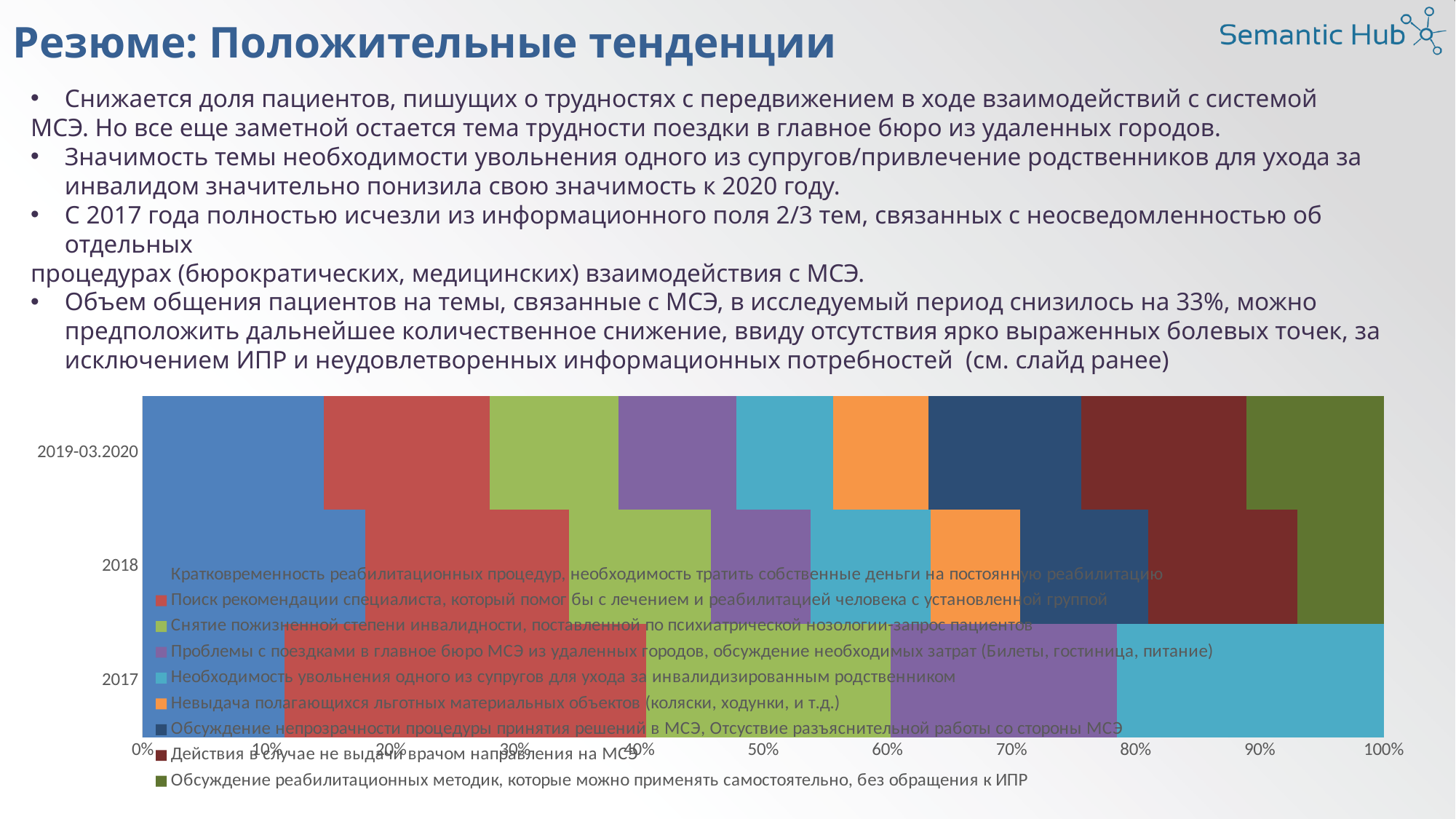
In which bar is the blue segment 'Кратковременность реабилитационных процедур...' larger: 2017 or 2019-03.2020? 2019-03.2020 What is the label of the topmost bar in the chart? 2019-03.2020 How many series does the chart legend list? 9 Is the share of the first (blue) series, 'Кратковременность реабилитационных процедур...', in the 2017 bar greater or less than 30%? less What is the highest tick value shown on the x axis of the chart? 100% Is the share of the teal series 'Необходимость увольнения одного из супругов...' in the 2017 bar greater or less than 10%? greater How many categories (time periods) are plotted on the y axis of the chart? 3 In which bar is the teal segment 'Необходимость увольнения одного из супругов...' larger: 2017 or 2019-03.2020? 2017 Does the share of the blue series 'Кратковременность реабилитационных процедур...' increase or decrease from 2017 to 2019-03.2020? increase What kind of chart is shown on the slide? Stacked bar chart Is the share of the first (blue) series, 'Кратковременность реабилитационных процедур...', in the 2019-03.2020 bar greater or less than 20%? less